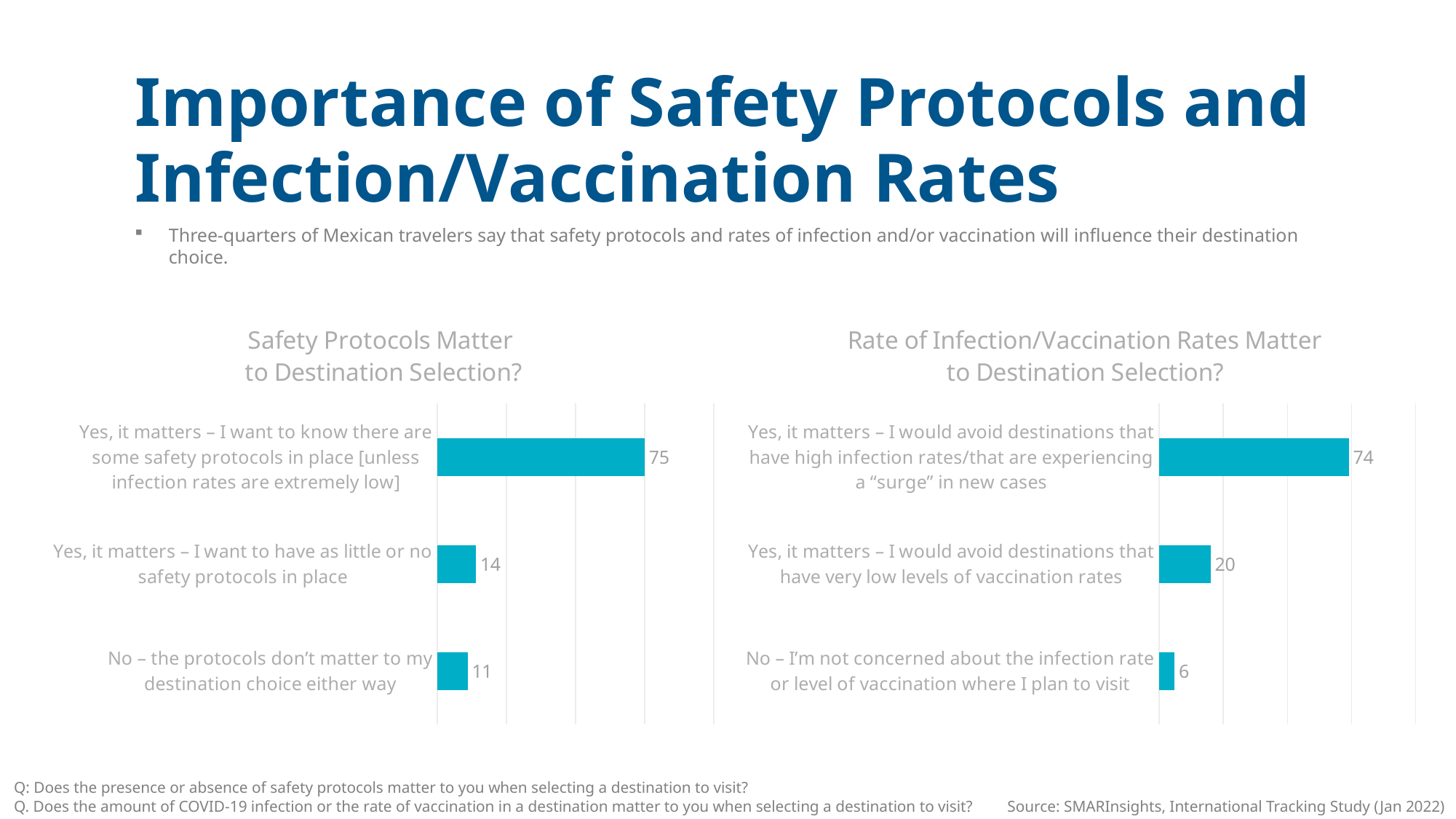
In the 'Rate of Infection/Vaccination Rates Matter to Destination Selection?' chart, which category has the highest value? Yes, it matters – I would avoid destinations that have high infection rates/that are experiencing a "surge" in new cases In the 'Safety Protocols Matter to Destination Selection?' chart, what is the difference between the values for 'Yes, it matters – I want to have as little or no safety protocols in place' and 'No – the protocols don't matter to my destination choice either way'? 3 In the 'Safety Protocols Matter to Destination Selection?' chart, which category has the lowest value? No – the protocols don't matter to my destination choice either way In the 'Safety Protocols Matter to Destination Selection?' chart, what is the value for 'No – the protocols don't matter to my destination choice either way'? 11 What type of chart is the 'Rate of Infection/Vaccination Rates Matter to Destination Selection?' chart? Bar chart How many charts are shown on the slide? 2 In the 'Rate of Infection/Vaccination Rates Matter to Destination Selection?' chart, what is the value for 'Yes, it matters – I would avoid destinations that have very low levels of vaccination rates'? 20 Which is larger: the top bar in the 'Safety Protocols Matter to Destination Selection?' chart or the top bar in the 'Rate of Infection/Vaccination Rates Matter to Destination Selection?' chart? Safety Protocols Matter to Destination Selection? (75) In the 'Rate of Infection/Vaccination Rates Matter to Destination Selection?' chart, what is the value for 'No – I'm not concerned about the infection rate or level of vaccination where I plan to visit'? 6 How many categories are shown in the 'Safety Protocols Matter to Destination Selection?' chart? 3 In the 'Rate of Infection/Vaccination Rates Matter to Destination Selection?' chart, what is the difference between the highest and lowest values? 68 In the 'Safety Protocols Matter to Destination Selection?' chart, what is the value for 'Yes, it matters – I want to know there are some safety protocols in place [unless infection rates are extremely low]'? 75